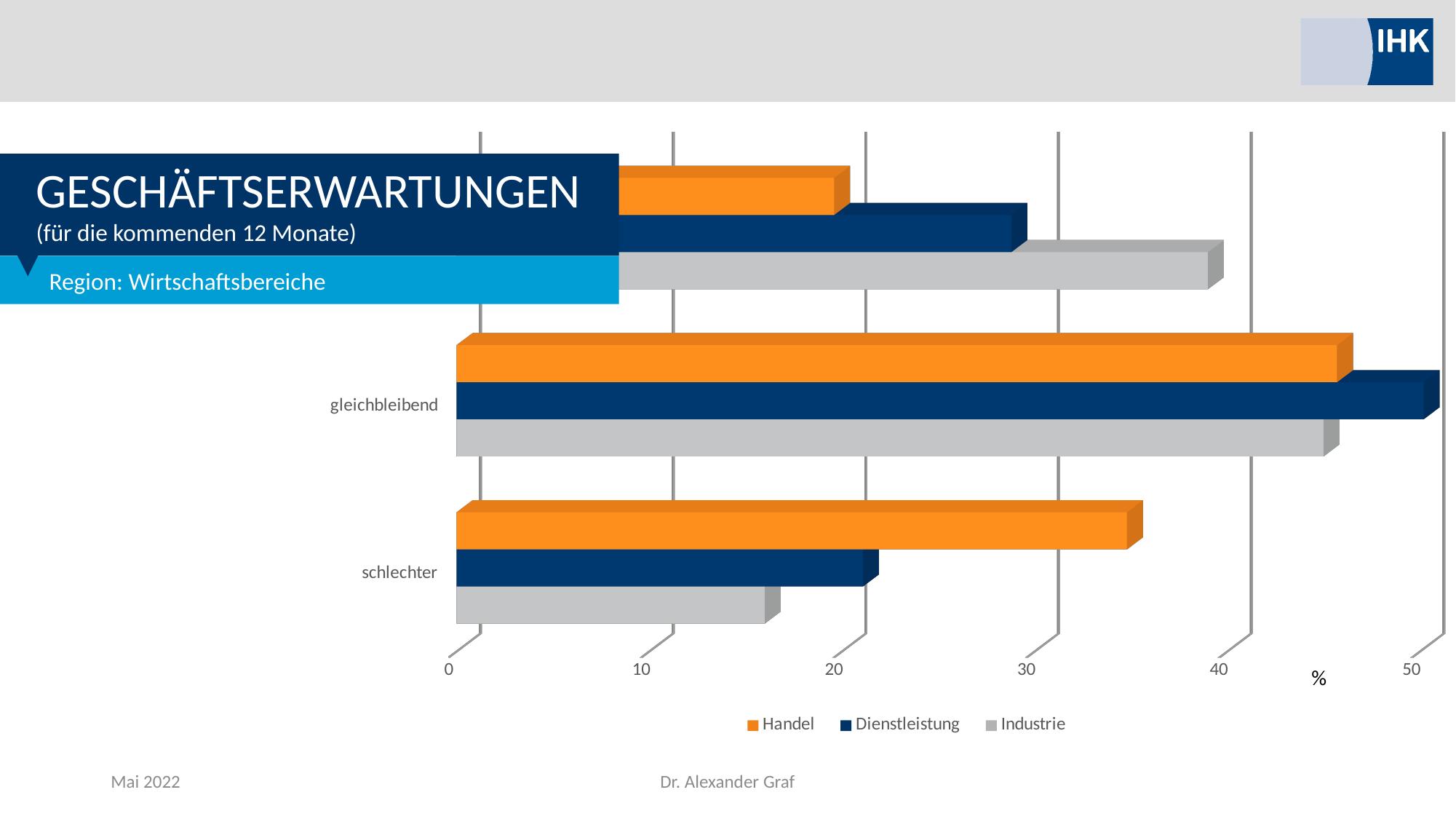
Is the value for Industrie in the 'gleichbleibend' category greater or less than 40? greater Is the value for Handel in the 'gleichbleibend' category greater or less than 40? greater What is the main title of the chart? GESCHÄFTSERWARTUNGEN In the 'schlechter' category, which series has the highest value? Handel What kind of chart is shown on the slide? bar chart Is the value for Dienstleistung in the 'schlechter' category greater or less than 30? less In the 'gleichbleibend' category, which is larger: Dienstleistung or Industrie? Dienstleistung How many series does the legend list? 3 In the 'schlechter' category, which series has the lowest value? Industrie Which series is shown in orange? Handel